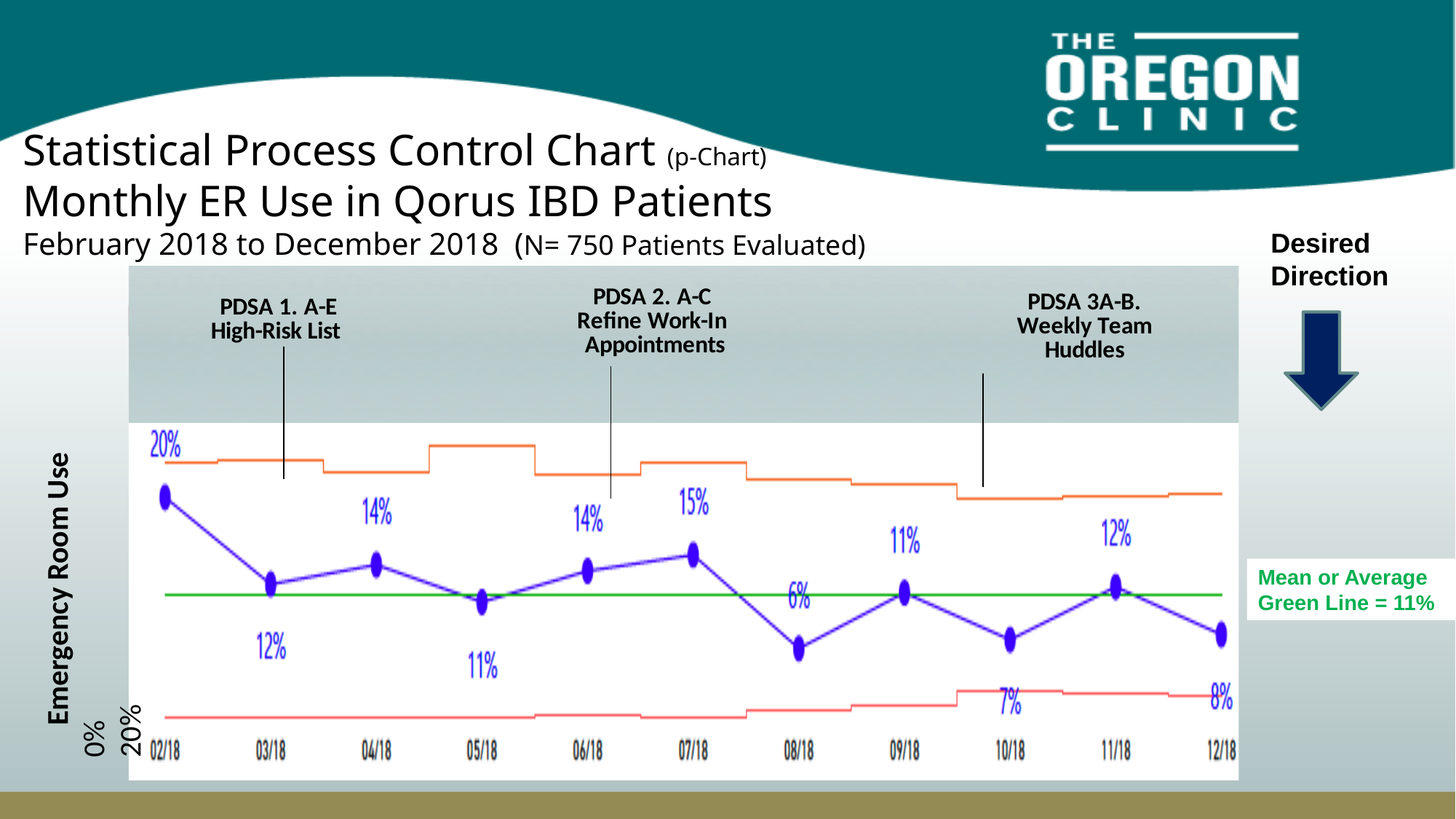
What is the difference between the Emergency Room Use values for 02/18 and 12/18? 12% What value does the green mean line on the chart represent? 11% Which month has a higher Emergency Room Use value, 07/18 or 10/18? 07/18 What is the difference between the Emergency Room Use values for 07/18 and 08/18? 9% How many monthly data points are plotted on the chart? 11 What kind of chart is shown on the slide? Line chart What is the Emergency Room Use value for 08/18? 6% Overall, does Emergency Room Use rise or fall from 02/18 to 12/18? Fall Which month has the lowest Emergency Room Use value? 08/18 What is the Emergency Room Use value for 12/18? 8% What is the Emergency Room Use value for 02/18? 20% Which month has the highest Emergency Room Use value? 02/18